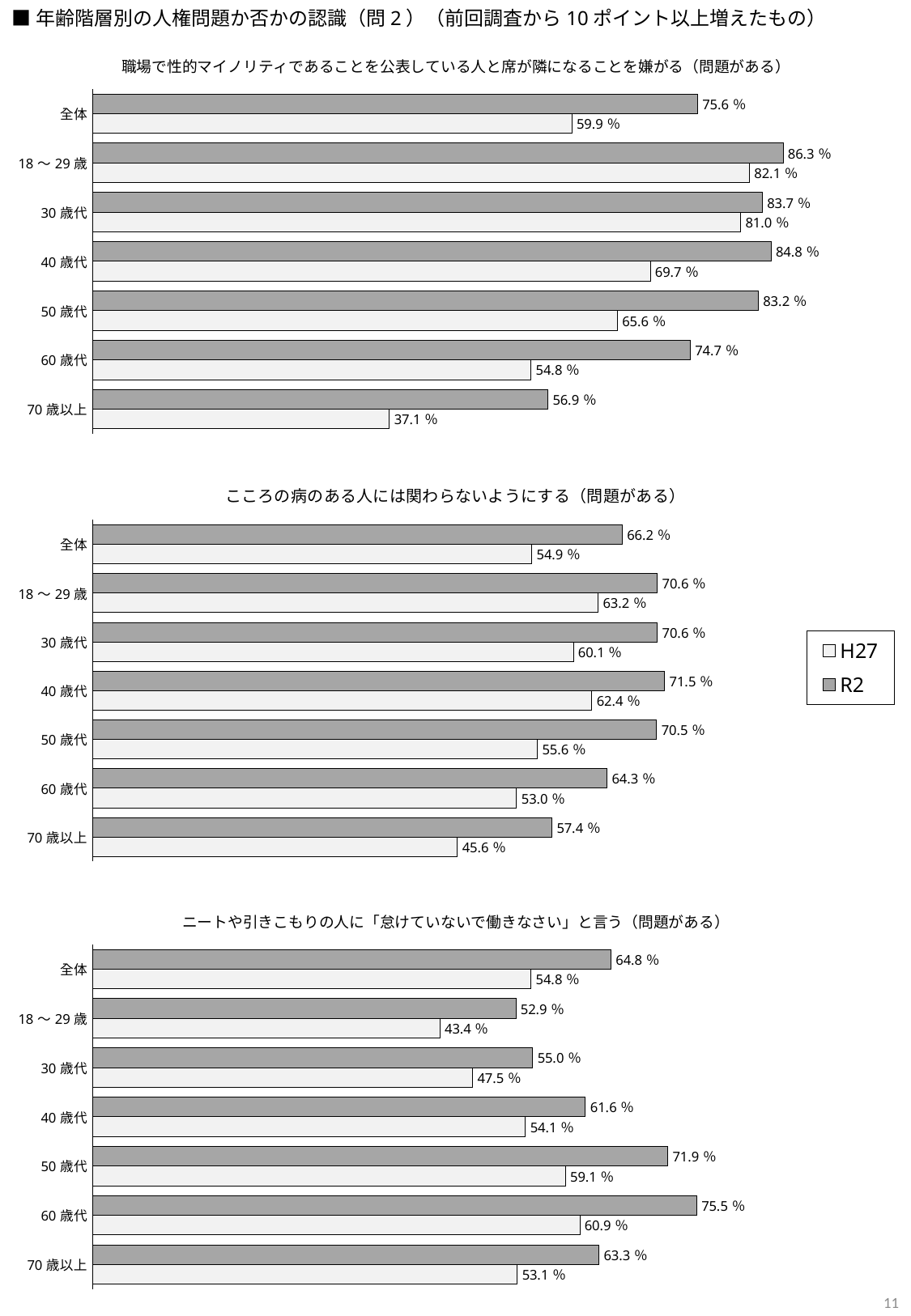
In the bottom chart (ニートや引きこもりの人に「怠けていないで働きなさい」と言う), what is the R2 value for 60 歳代? 75.5 % In the middle chart, which age category has the lowest H27 value? 70 歳以上 In the middle chart (こころの病のある人には関わらないようにする), what is the H27 value for 50 歳代? 55.6 % In the middle chart, what is the difference between the R2 and H27 values for 全体? 11.3 % In the top chart, what is the H27 value for 70 歳以上? 37.1 % In the top chart (職場で性的マイノリティであることを公表している人と席が隣になることを嫌がる), what is the R2 value for 全体? 75.6 % In the bottom chart, which is larger: the R2 value for 50 歳代 or the R2 value for 40 歳代? 50 歳代 What type of chart is the top chart? Bar chart In the top chart, what is the difference between the R2 and H27 values for 40 歳代? 15.1 % How many series does the legend list? 2 In the bottom chart, which age category has the lowest R2 value? 18 ～ 29 歳 In the top chart, which age category has the highest R2 value? 18 ～ 29 歳